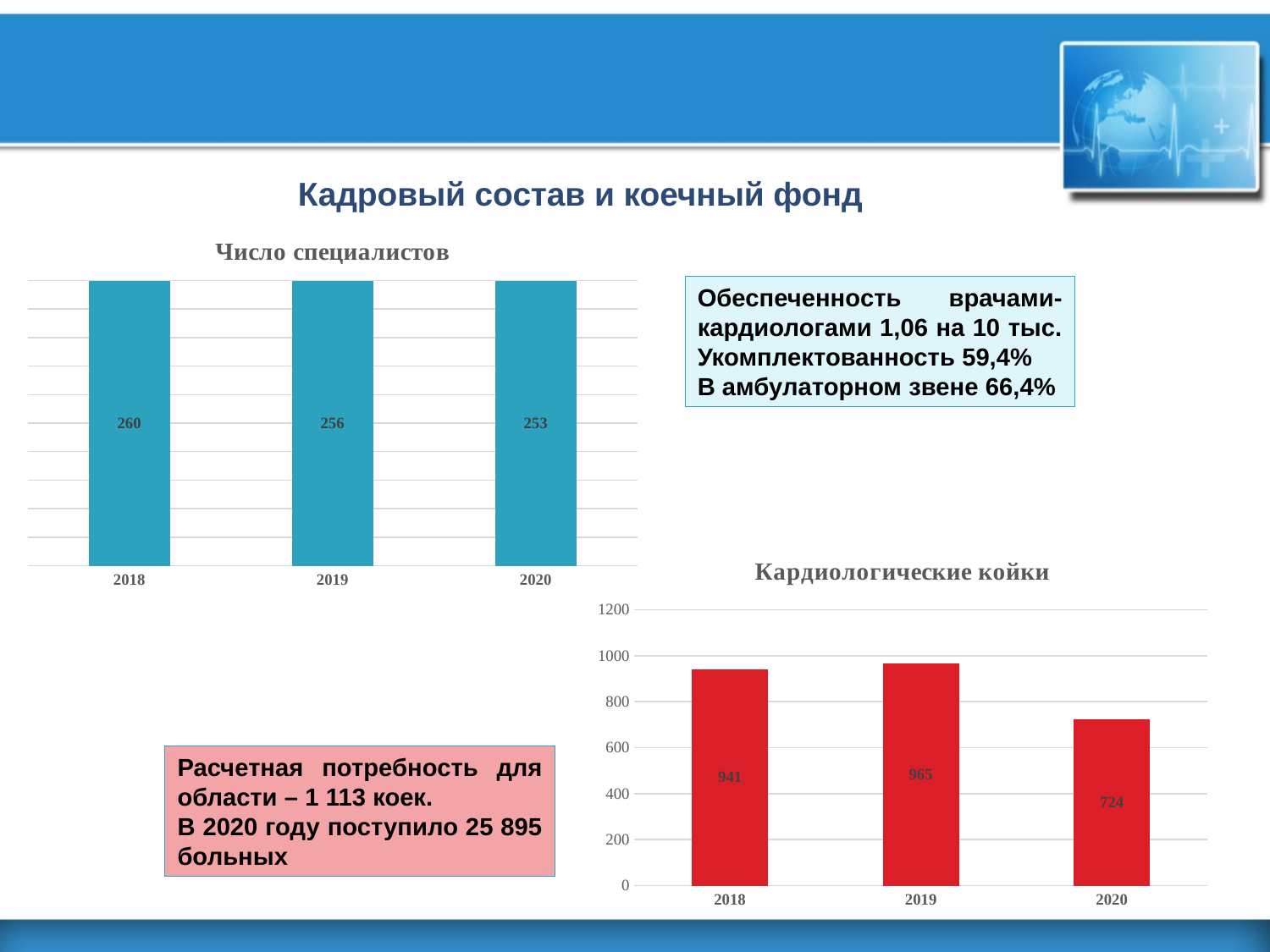
In the chart titled "Число специалистов", which year has the lowest value? 2020 In the chart titled "Кардиологические койки", what is the difference between the 2019 and 2020 values? 241 In the chart titled "Кардиологические койки", what is the value for 2019? 965 In the chart titled "Число специалистов", do the values rise or fall from 2018 to 2020? fall How many years are shown in the chart titled "Кардиологические койки"? 3 In the chart titled "Число специалистов", what is the value for 2020? 253 What kind of chart is the chart titled "Кардиологические койки"? bar chart In the chart titled "Кардиологические койки", which year has the highest value? 2019 In the chart titled "Кардиологические койки", what is the value for 2020? 724 In the chart titled "Кардиологические койки", is the value for 2020 greater or less than 800? less In the chart titled "Число специалистов", what is the value for 2018? 260 In the chart titled "Число специалистов", what is the difference between the 2018 and 2020 values? 7